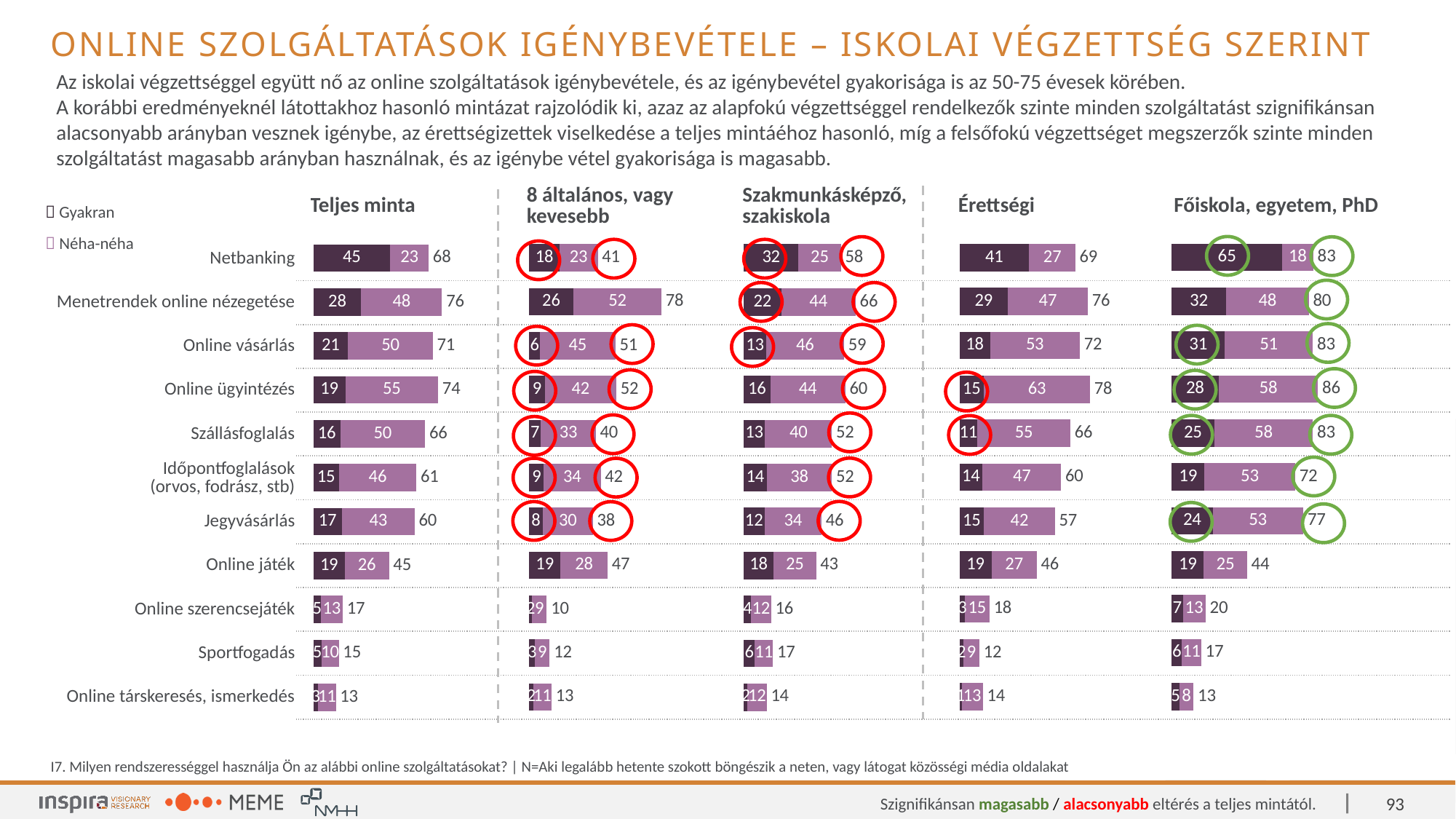
In the "8 általános, vagy kevesebb" chart, what is the "Néha-néha" value for Menetrendek online nézegetése? 52 How many categories (online services) are listed in each chart? 11 In the "Érettségi" chart, what is the sum of the "Gyakran" and "Néha-néha" values for Szállásfoglalás? 66 In the "Szakmunkásképző, szakiskola" chart, which category has the lowest total value? Online társkeresés, ismerkedés How many series does the legend list? 2 What is the difference between the total for Online vásárlás in the "Főiskola, egyetem, PhD" chart and in the "8 általános, vagy kevesebb" chart? 32 In the "Főiskola, egyetem, PhD" chart, what is the "Gyakran" value for Netbanking? 65 In the "Teljes minta" chart, what is the total value shown for Netbanking? 68 In the "Teljes minta" chart, which is larger: the total for Szállásfoglalás or the total for Jegyvásárlás? Szállásfoglalás Which two series are named in the legend? Gyakran and Néha-néha What kind of chart is used on this slide? Stacked bar chart In the "Érettségi" chart, which category has the highest total value? Online ügyintézés